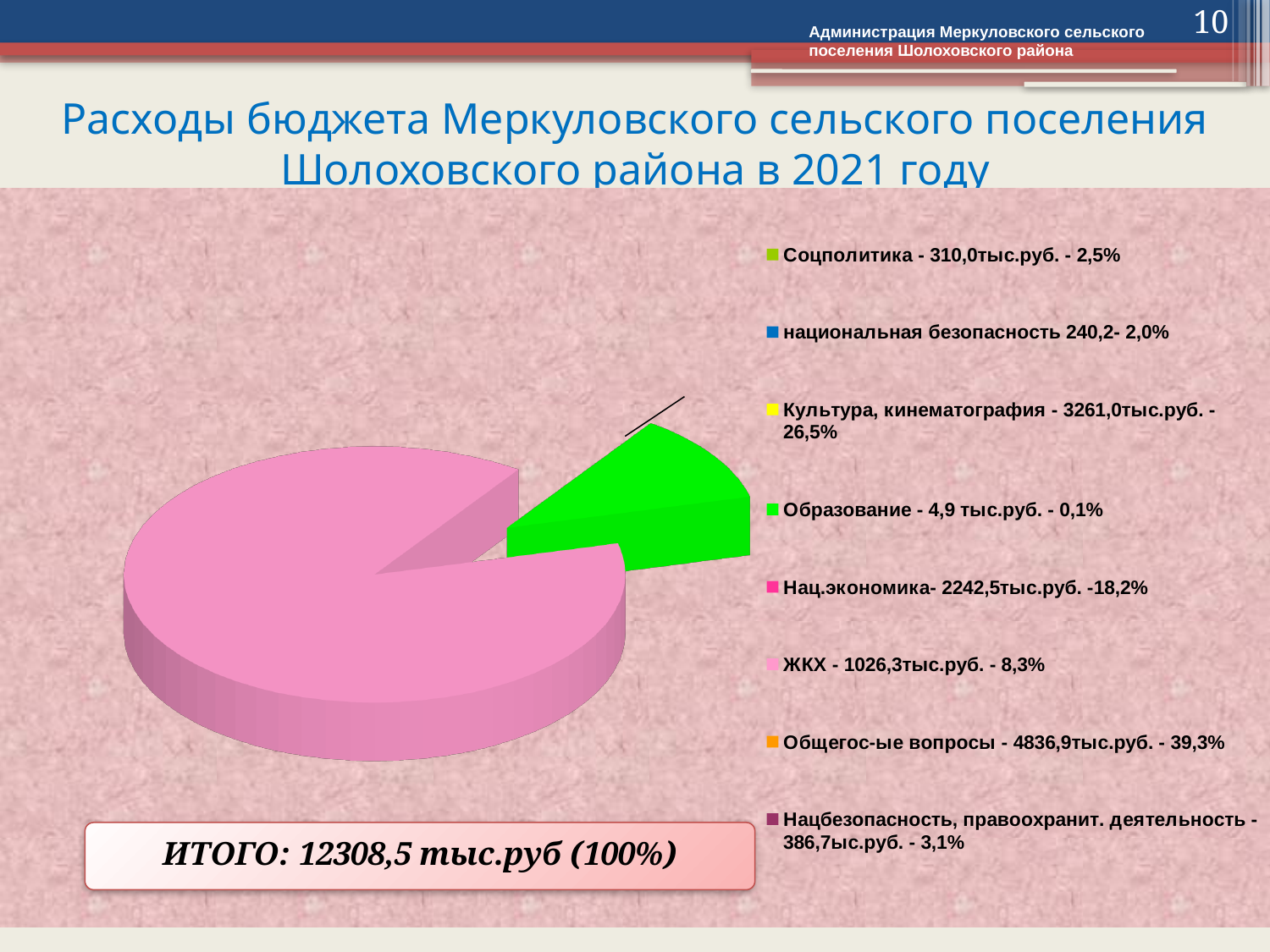
What kind of chart is shown on the slide? pie chart What share of the budget expenses goes to Общегос-ые вопросы according to the legend? 39,3% What percentage is shown for Нац.экономика in the legend? 18,2% What is the amount for ЖКХ according to the legend? 1026,3тыс.руб. Which category has the smallest share of expenses according to the legend? Образование What is the amount for Культура, кинематография according to the legend? 3261,0тыс.руб. What year do the budget expenses in the chart title refer to? 2021 What is the total budget expense shown on the slide (ИТОГО)? 12308,5 тыс.руб Which has a larger share: Соцполитика or национальная безопасность? Соцполитика Which category has the largest share of expenses according to the legend? Общегос-ые вопросы What is the difference in percentage points between Культура, кинематография and Нац.экономика? 8,3% How many categories does the legend of the pie chart list? 8